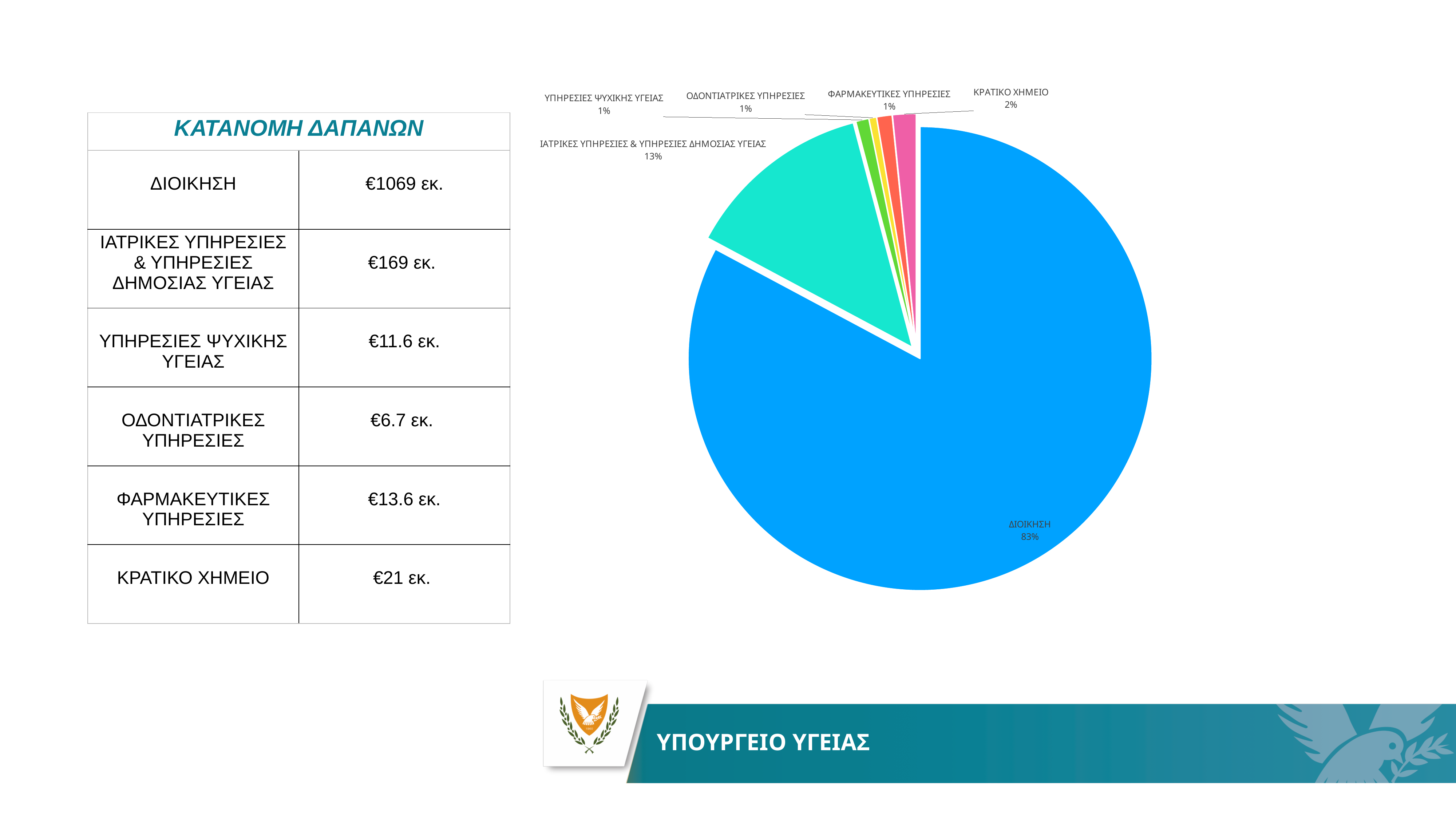
How many slices does the pie chart have? 6 What share of the pie does ΦΑΡΜΑΚΕΥΤΙΚΕΣ ΥΠΗΡΕΣΙΕΣ represent? 1% What is the difference in percentage points between the ΚΡΑΤΙΚΟ ΧΗΜΕΙΟ slice and the ΦΑΡΜΑΚΕΥΤΙΚΕΣ ΥΠΗΡΕΣΙΕΣ slice? 1% What share of the pie does ΥΠΗΡΕΣΙΕΣ ΨΥΧΙΚΗΣ ΥΓΕΙΑΣ represent? 1% What share of the pie does ΙΑΤΡΙΚΕΣ ΥΠΗΡΕΣΙΕΣ & ΥΠΗΡΕΣΙΕΣ ΔΗΜΟΣΙΑΣ ΥΓΕΙΑΣ represent? 13% What is the difference in percentage points between the ΔΙΟΙΚΗΣΗ slice and the ΙΑΤΡΙΚΕΣ ΥΠΗΡΕΣΙΕΣ & ΥΠΗΡΕΣΙΕΣ ΔΗΜΟΣΙΑΣ ΥΓΕΙΑΣ slice? 70% What colour is the ΔΙΟΙΚΗΣΗ slice of the pie chart? blue Which category has the largest slice of the pie chart? ΔΙΟΙΚΗΣΗ What kind of chart is shown on the slide? pie chart Which is larger in the pie chart: ΚΡΑΤΙΚΟ ΧΗΜΕΙΟ or ΟΔΟΝΤΙΑΤΡΙΚΕΣ ΥΠΗΡΕΣΙΕΣ? ΚΡΑΤΙΚΟ ΧΗΜΕΙΟ